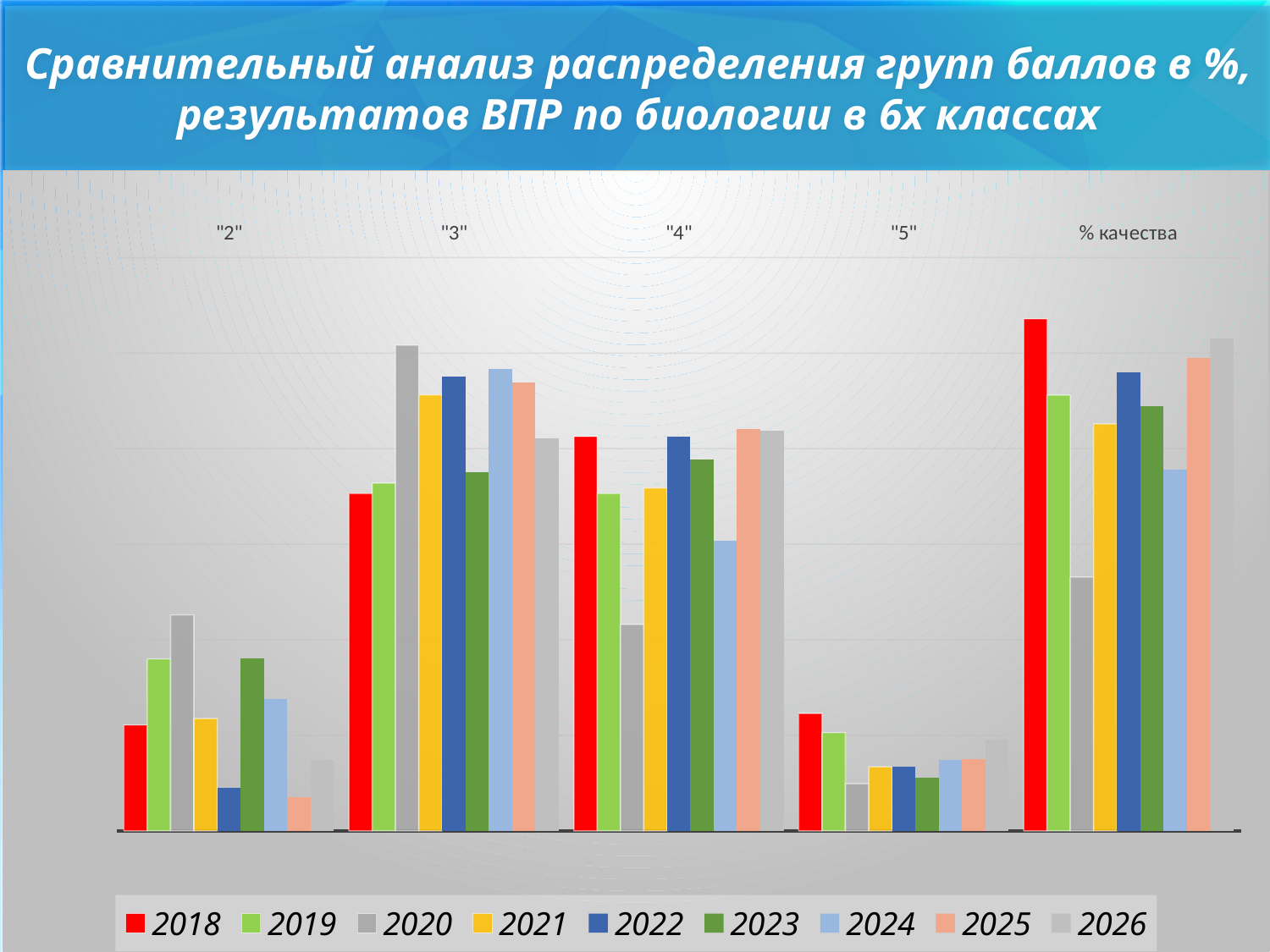
Which year has the lowest value in the "2" category? 2025 Which year has the highest value in the "% качества" category? 2018 What kind of chart is shown on the slide? Bar chart Which year is listed first in the chart legend? 2018 Which year has the highest value in the "3" category? 2020 How many categories are shown along the x axis of the chart? 5 Which year has the lowest value in the "% качества" category? 2020 In the "2" category, which is larger: the value for 2018 or the value for 2019? 2019 Which year has the highest value in the "2" category? 2020 Which year has the lowest value in the "4" category? 2020 How many series does the chart legend list? 9